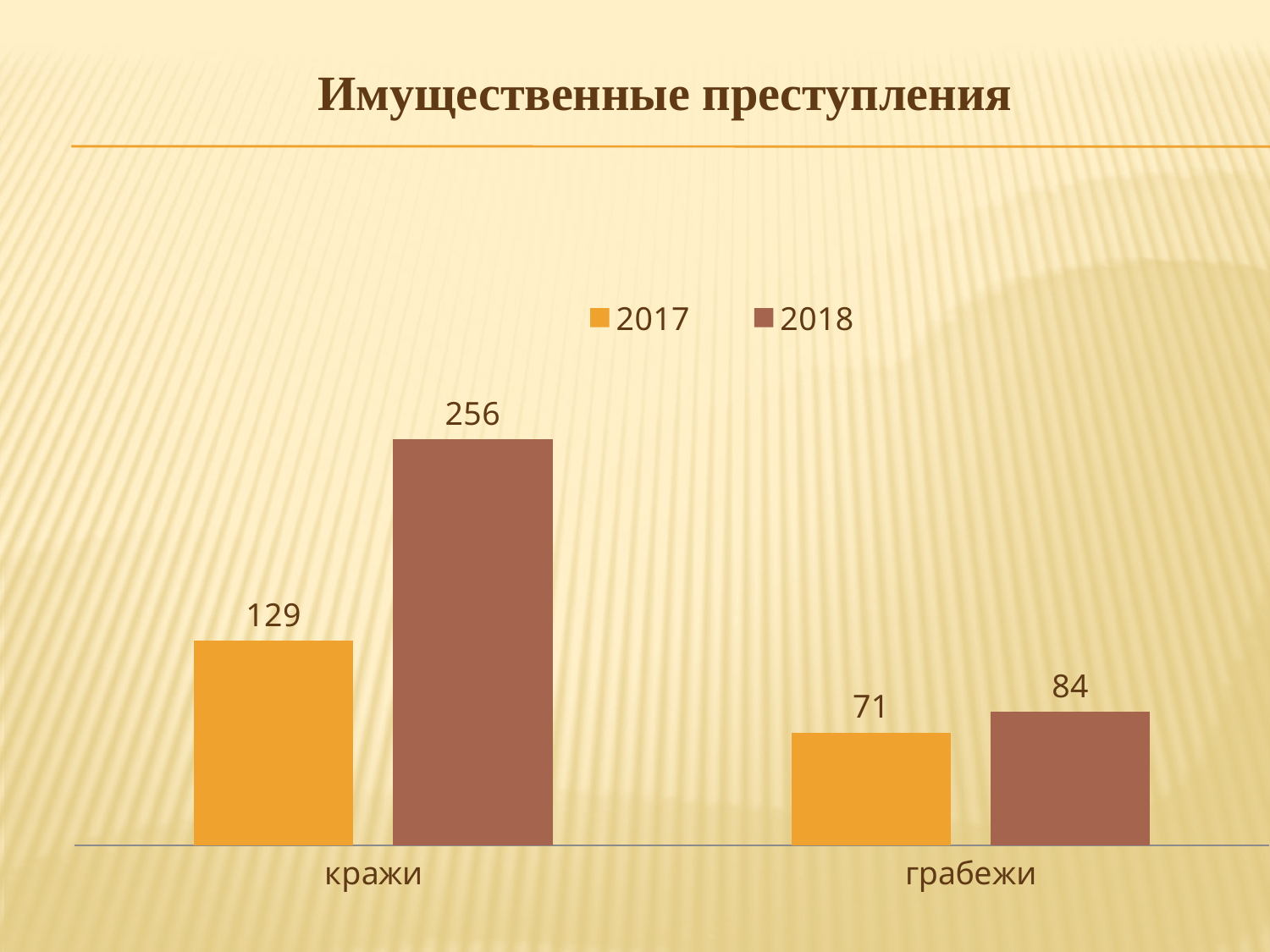
What is the value for грабежи in 2018? 84 What is the difference between the 2018 and 2017 values for кражи? 127 What is the value for кражи in 2017? 129 Which category has the highest value in the 2018 series? кражи What kind of chart is shown on the slide? bar chart Which is larger for грабежи: the 2017 value or the 2018 value? 2018 How many categories are shown on the x axis? 2 What is the difference between the 2018 and 2017 values for грабежи? 13 How many series does the legend list? 2 What is the value for кражи in 2018? 256 What is the value for грабежи in 2017? 71 Which category has the lowest value in the 2017 series? грабежи